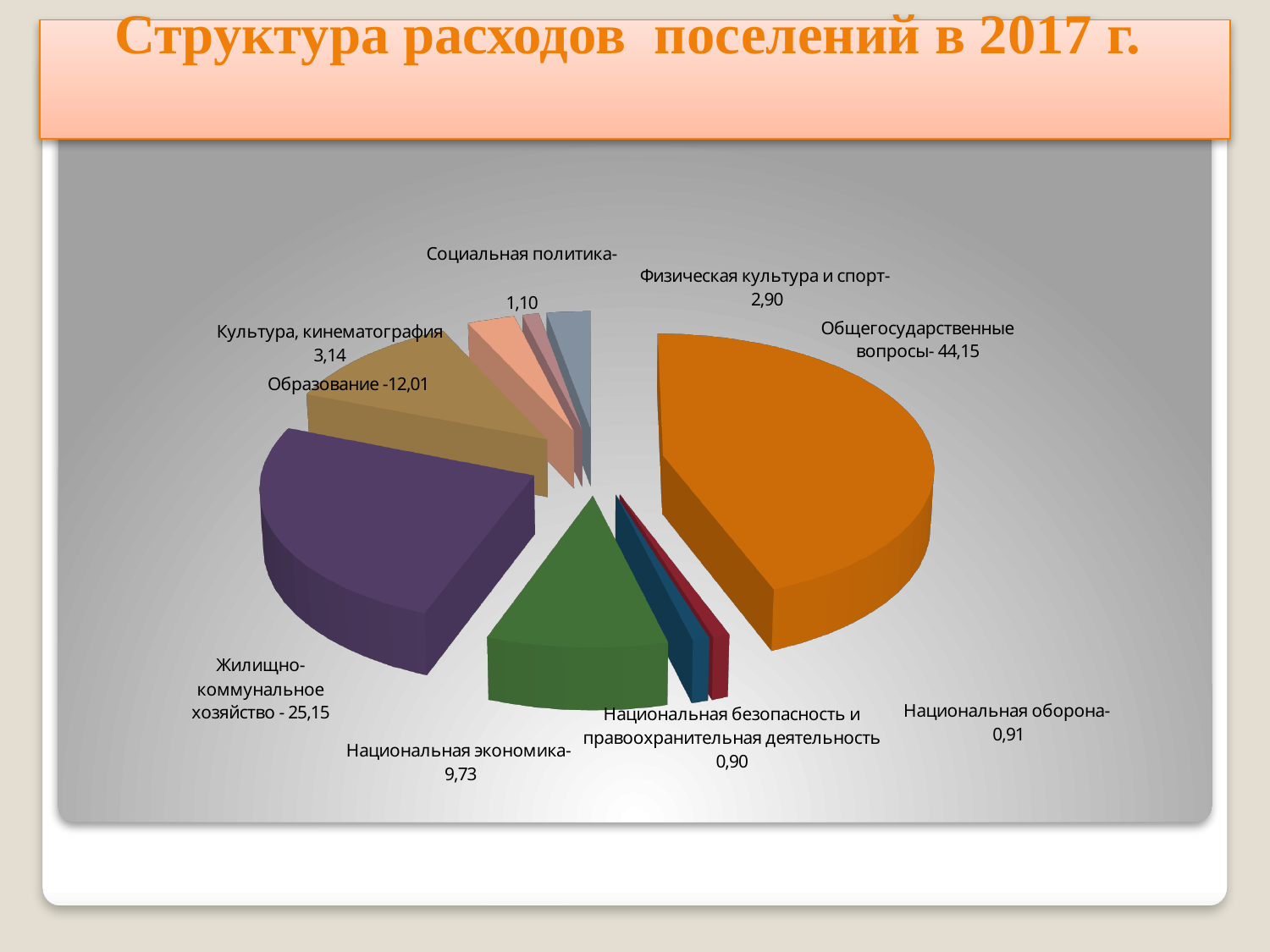
What is the difference between the values for Общегосударственные вопросы and Жилищно-коммунальное хозяйство? 19,00 How many categories are shown in the pie chart? 9 Which is larger: Образование or Национальная экономика? Образование Which category has the largest slice of the pie? Общегосударственные вопросы What is the value for Образование? 12,01 What is the value for Национальная экономика? 9,73 What is the value for Жилищно-коммунальное хозяйство? 25,15 What is the value for Общегосударственные вопросы? 44,15 What kind of chart is shown on the slide? Pie chart What is the value for Физическая культура и спорт? 2,90 What is the title of the slide? Структура расходов поселений в 2017 г. Which category has the smallest value? Национальная безопасность и правоохранительная деятельность